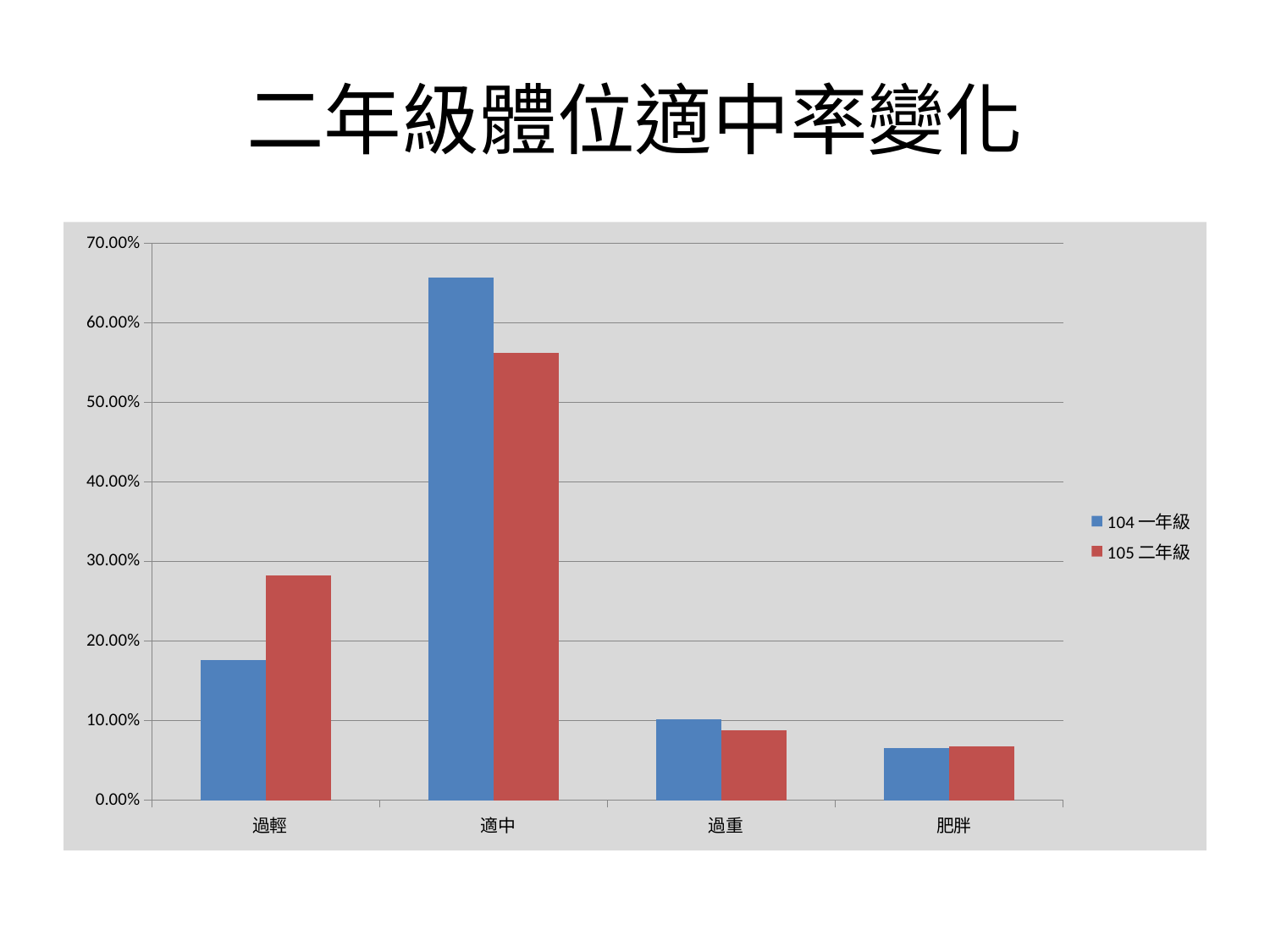
Is the value for 適中 in the 104 一年級 series greater or less than 60.00%? greater What kind of chart is shown on the slide? bar chart What is the title of the slide containing the chart? 二年級體位適中率變化 For the 適中 category, which series has the larger value, 104 一年級 or 105 二年級? 104 一年級 Which category has the lowest value for the 104 一年級 series? 肥胖 Which category has the highest value for the 105 二年級 series? 適中 Is the value for 過輕 in the 105 二年級 series greater or less than 30.00%? less How many categories are shown on the x axis of the chart? 4 How many series does the chart's legend list? 2 For the 過輕 category, which series has the larger value, 104 一年級 or 105 二年級? 105 二年級 Which category has the highest value for the 104 一年級 series? 適中 Is the value for 過重 in the 105 二年級 series greater or less than 10.00%? less